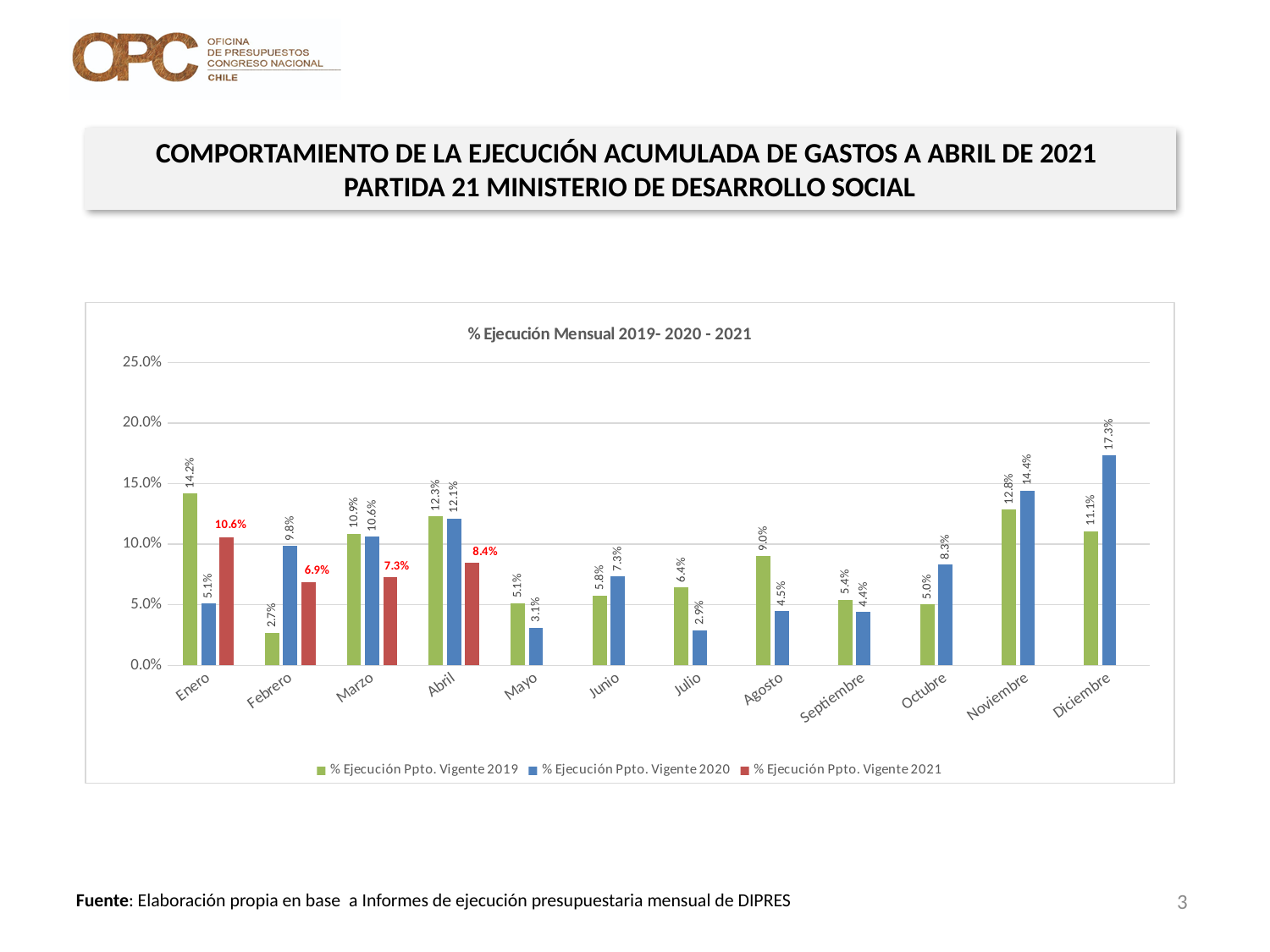
What kind of chart is shown? Bar chart Is the value for % Ejecución Ppto. Vigente 2020 in Noviembre greater or less than 10.0%? greater What is the value for % Ejecución Ppto. Vigente 2020 in Diciembre? 17.3% What is the value for % Ejecución Ppto. Vigente 2019 in Agosto? 9.0% How many series does the legend list? 3 What is the value for % Ejecución Ppto. Vigente 2021 in Enero? 10.6% Which month has the highest value for % Ejecución Ppto. Vigente 2020? Diciembre How many months are shown on the x axis? 12 What is the difference between the 2019 and 2020 values in Enero? 9.1% Which is larger in Abril: the 2019 value or the 2021 value? 2019 value (12.3%) Which month has the lowest value for % Ejecución Ppto. Vigente 2019? Febrero What is the title of the chart? % Ejecución Mensual 2019- 2020 - 2021